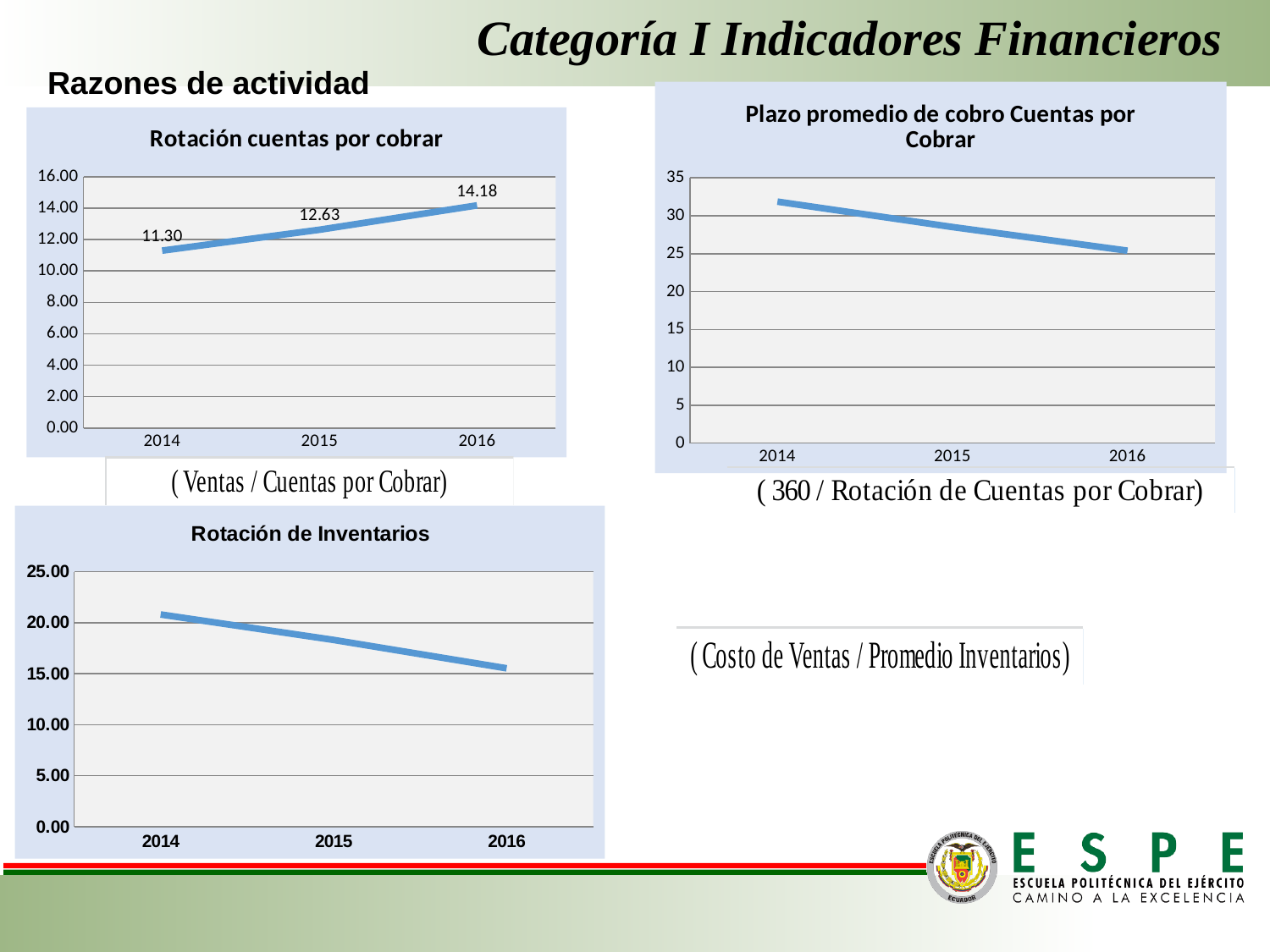
How many years are plotted in the 'Rotación de Inventarios' chart? 3 In the 'Rotación de Inventarios' chart, is the value for 2014 greater or less than 20.00? greater In the 'Rotación cuentas por cobrar' chart, which year has the lowest value? 2014 In the 'Rotación de Inventarios' chart, which year has the lowest value? 2016 In the 'Rotación cuentas por cobrar' chart, what is the value for 2015? 12.63 In the 'Plazo promedio de cobro Cuentas por Cobrar' chart, do the values rise or fall from 2014 to 2016? fall In the 'Rotación cuentas por cobrar' chart, do the values rise or fall from 2014 to 2016? rise In the 'Rotación cuentas por cobrar' chart, what is the value for 2014? 11.30 In the 'Plazo promedio de cobro Cuentas por Cobrar' chart, is the value for 2014 greater or less than 30? greater In the 'Rotación cuentas por cobrar' chart, what is the difference between the 2016 and 2014 values? 2.88 In the 'Rotación cuentas por cobrar' chart, which year has the highest value? 2016 What kind of chart is 'Plazo promedio de cobro Cuentas por Cobrar'? line chart